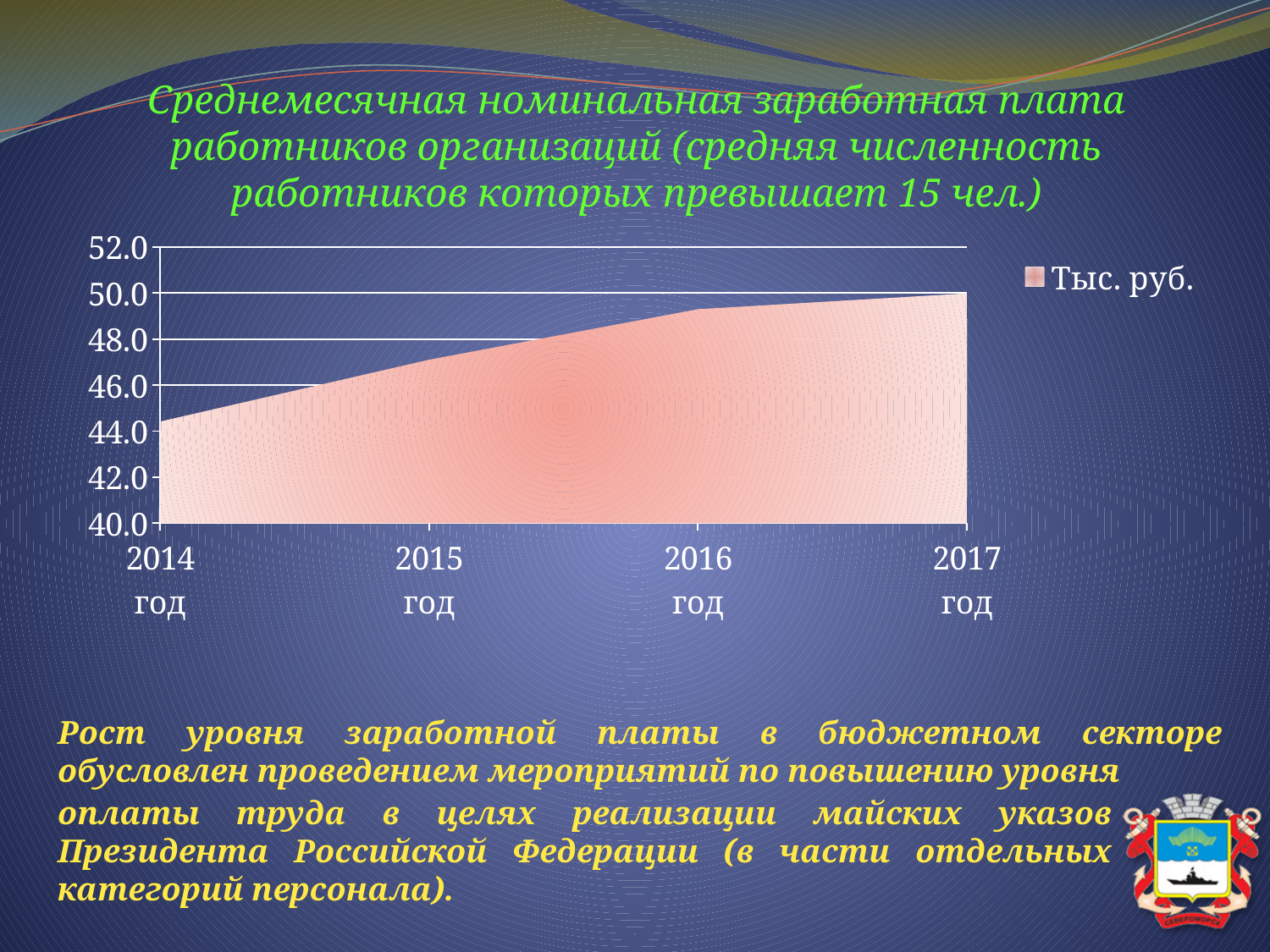
What kind of chart is shown on the slide? area chart Is the value for 2015 год greater or less than 46.0? greater How many series does the chart legend list? 1 What is the legend entry of the series shown in the chart? Тыс. руб. Is the value for 2016 год greater or less than 48.0? greater Which year has the highest value in the chart? 2017 год How many years are plotted along the x axis of the chart? 4 Which is larger, the value for 2015 год or the value for 2016 год? 2016 год Is the value for 2014 год greater or less than 46.0? less Which year has the lowest value in the chart? 2014 год Do the values rise or fall from 2014 год to 2017 год? rise What is the lowest value shown on the vertical axis of the chart? 40.0